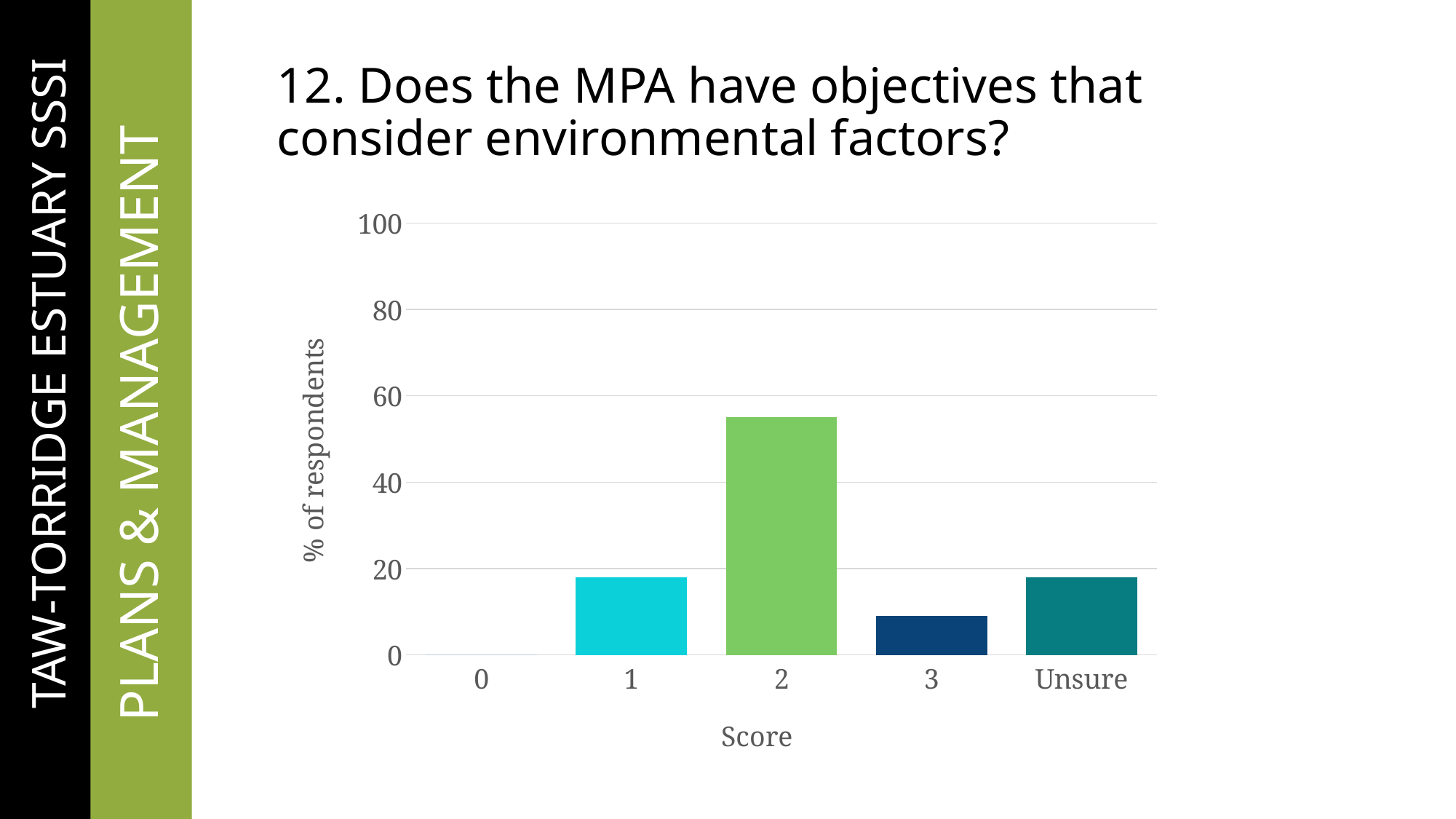
Is the value for Unsure greater or less than 40? less Is the value for score 2 greater or less than 40? greater Is the value for score 2 greater or less than 60? less Which has a higher percentage of respondents, score 1 or score 3? 1 Which has a higher percentage of respondents, score 2 or score 3? 2 What is the label of the x axis? Score What kind of chart is shown on the slide? bar chart What is the label of the y axis? % of respondents Which score category has the highest percentage of respondents? 2 How many score categories are shown on the x axis? 5 Which score category has the lowest percentage of respondents? 0